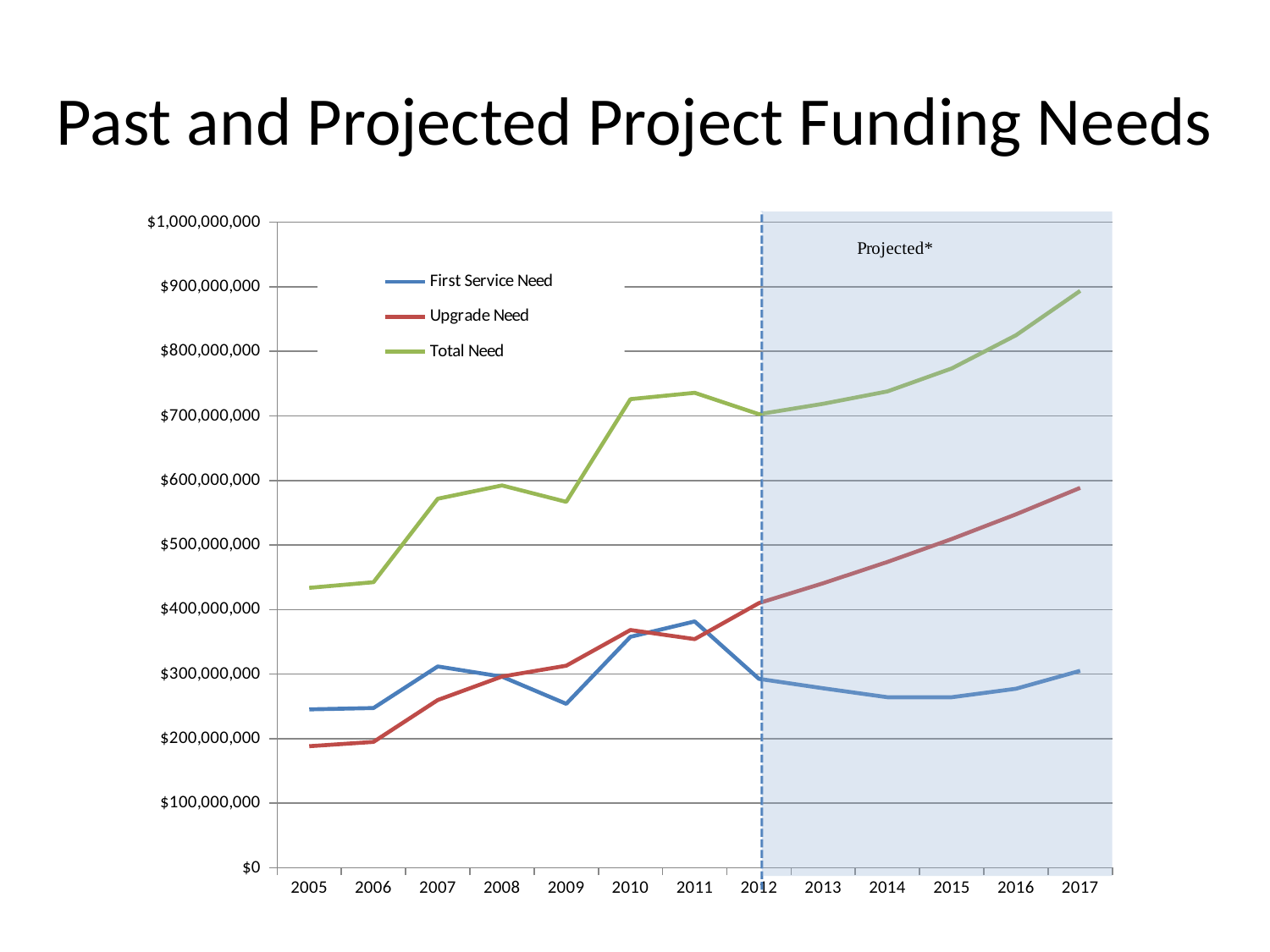
Is the Total Need value for 2017 greater or less than $800,000,000? greater Does Upgrade Need rise or fall from 2012 to 2017? rise How many years are plotted along the x axis? 13 Is the Total Need value for 2010 greater or less than $700,000,000? greater In which year is Total Need highest? 2017 Which series is drawn in green? Total Need In which year is Upgrade Need lowest? 2005 In which year is First Service Need highest? 2011 Is the Upgrade Need value for 2005 greater or less than $200,000,000? less How many series does the legend list? 3 What kind of chart is shown on the slide? line chart In 2017, which is larger: Upgrade Need or First Service Need? Upgrade Need